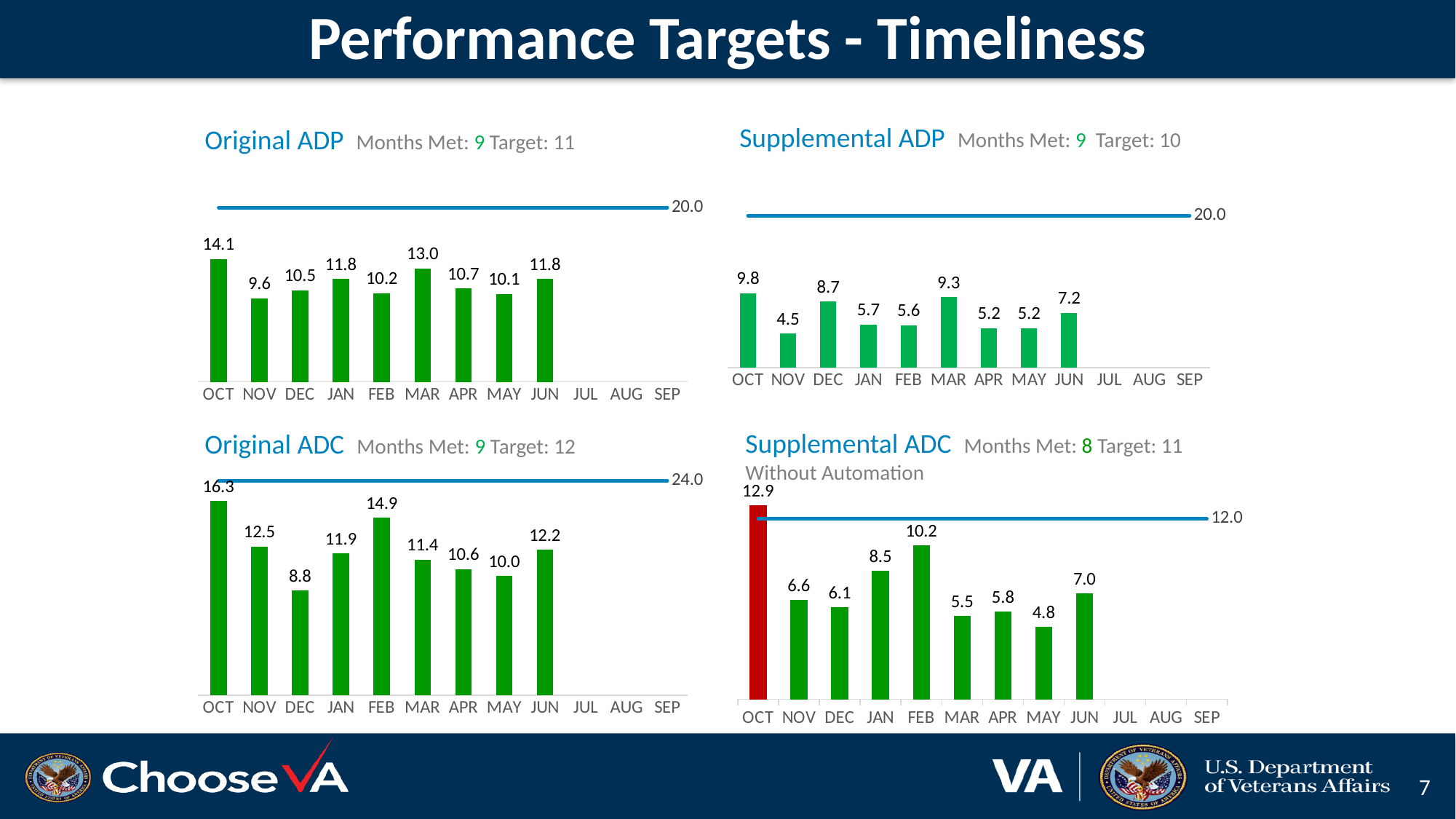
In the Supplemental ADC chart, which is larger, the JAN value or the JUN value? JAN In the Original ADP chart, what is the difference between the MAR value and the NOV value? 3.4 In the Original ADC chart, what is the value for DEC? 8.8 In the Supplemental ADP chart, which month has the lowest value? NOV What kind of chart is the Original ADC chart? bar chart In the Original ADC chart, which month has the highest value? OCT In the Original ADC chart, what is the difference between the OCT value and the FEB value? 1.4 In the Supplemental ADC chart, what value is labelled on the horizontal target line? 12.0 In the Supplemental ADP chart, how many months have a plotted bar? 9 In the Supplemental ADC chart, which month's bar is coloured red instead of green? OCT In the Supplemental ADC chart, what is the value for FEB? 10.2 In the Original ADP chart, what is the value for OCT? 14.1